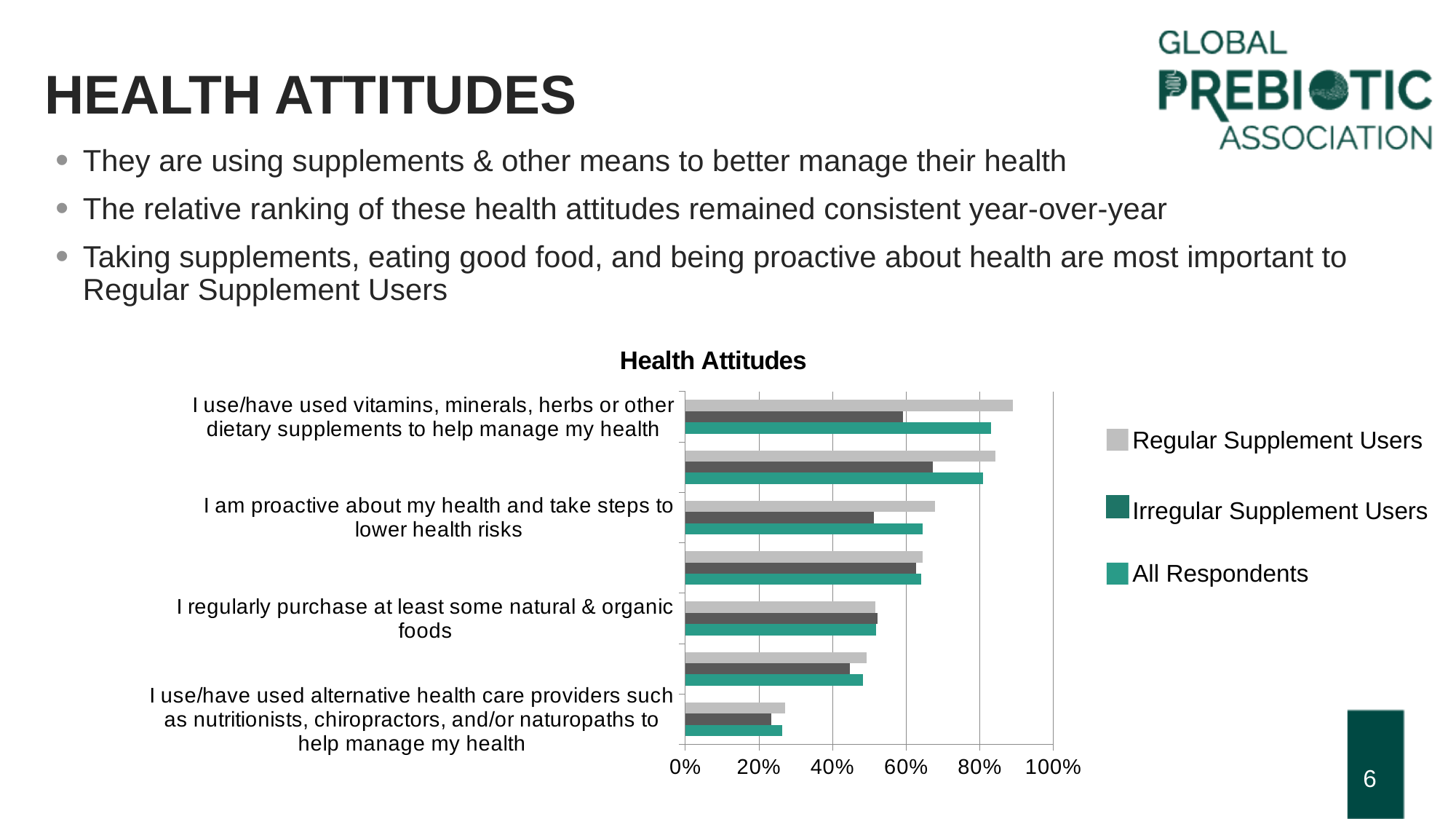
What is the title of the chart? Health Attitudes Is the Irregular Supplement Users value for 'I am proactive about my health and take steps to lower health risks' greater or less than 60%? less For 'I use/have used vitamins, minerals, herbs or other dietary supplements to help manage my health', which is larger: the Regular Supplement Users value or the Irregular Supplement Users value? Regular Supplement Users Which labelled category has the lowest All Respondents value? I use/have used alternative health care providers such as nutritionists, chiropractors, and/or naturopaths to help manage my health How many groups of bars (categories) are plotted in the chart? 7 Is the Irregular Supplement Users value for 'I use/have used alternative health care providers such as nutritionists, chiropractors, and/or naturopaths to help manage my health' greater or less than 40%? less What type of chart is shown on the slide? Bar chart How many series does the chart legend list? 3 Which labelled category has the highest Regular Supplement Users value? I use/have used vitamins, minerals, herbs or other dietary supplements to help manage my health Is the Regular Supplement Users value for 'I use/have used vitamins, minerals, herbs or other dietary supplements to help manage my health' greater or less than 80%? greater Which series is shown in light grey in the legend? Regular Supplement Users